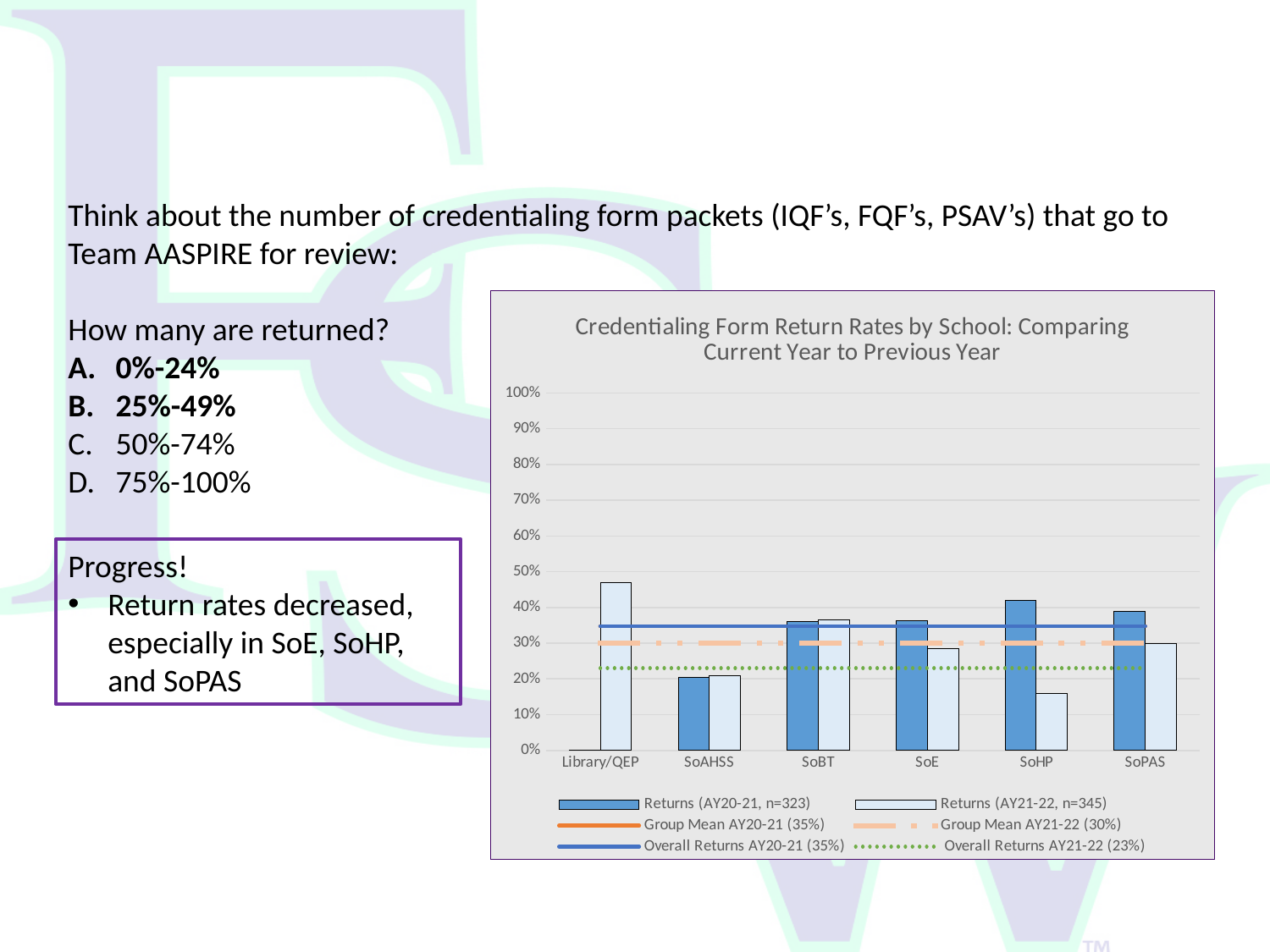
According to the legend, what is the Overall Returns value for AY21-22? 23% For SoHP, which is larger: the Returns (AY20-21, n=323) bar or the Returns (AY21-22, n=345) bar? Returns (AY20-21, n=323) What is the title of the chart? Credentialing Form Return Rates by School: Comparing Current Year to Previous Year What is the difference between the Overall Returns for AY20-21 (35%) and AY21-22 (23%) shown in the legend? 12 percentage points Which school has the highest Returns (AY21-22, n=345) bar? Library/QEP According to the legend, what is the Group Mean for AY21-22? 30% Is the Returns (AY21-22, n=345) value for Library/QEP greater or less than 40%? greater What kind of chart is shown on the slide? combination bar and line chart Is the Returns (AY21-22, n=345) value for SoHP greater or less than 20%? less How many schools/categories are shown on the x axis of the chart? 6 How many entries does the chart's legend list? 6 Which school has the lowest Returns (AY21-22, n=345) bar? SoHP